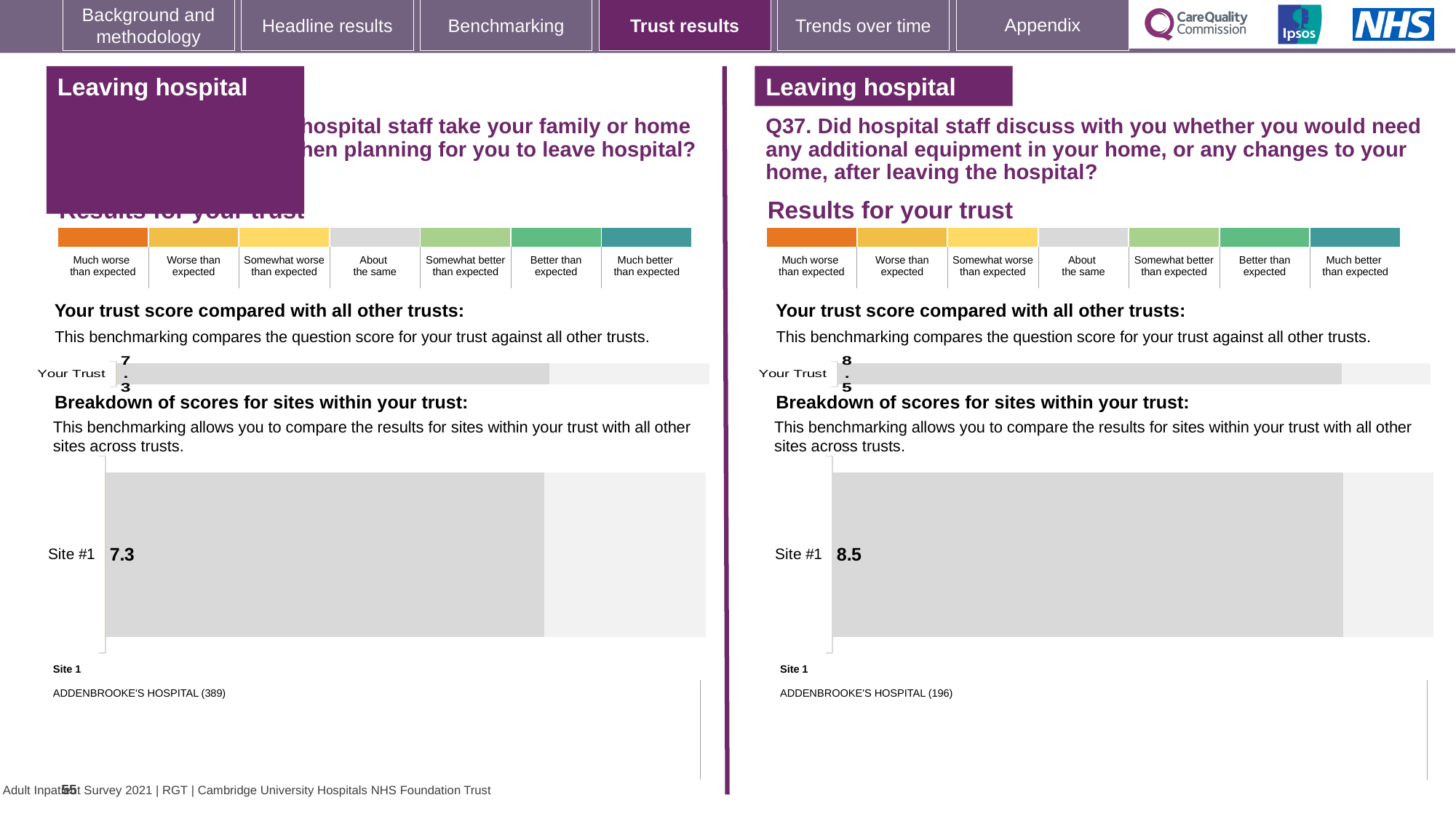
Which hospital is listed as Site 1 below the breakdown chart on the left-hand side? ADDENBROOKE'S HOSPITAL (389) How many sites are shown in the 'Breakdown of scores for sites within your trust' chart on the left-hand side? 1 On the right-hand side of the slide (Q37), what score is shown for Site #1 in the 'Breakdown of scores for sites within your trust' chart? 8.5 Which hospital is listed as Site 1 below the breakdown chart on the right-hand side (Q37)? ADDENBROOKE'S HOSPITAL (196) What kind of chart is used to show the Your Trust score on the left-hand side? Bar chart On the left-hand side of the slide, what score is shown for Site #1 in the 'Breakdown of scores for sites within your trust' chart? 7.3 What kind of chart is used to show the Site #1 score on the right-hand side (Q37)? Bar chart What is the difference between the Your Trust score on the right-hand side (Q37) and the Your Trust score on the left-hand side? 1.2 On the left-hand side of the slide, what is the score shown for Your Trust in the 'Your trust score compared with all other trusts' chart? 7.3 How many sites are shown in the 'Breakdown of scores for sites within your trust' chart on the right-hand side (Q37)? 1 Which is larger: the Site #1 score in the left-hand breakdown chart or the Site #1 score in the right-hand (Q37) breakdown chart? The right-hand (Q37) chart On the right-hand side of the slide (Q37), what is the score shown for Your Trust in the 'Your trust score compared with all other trusts' chart? 8.5